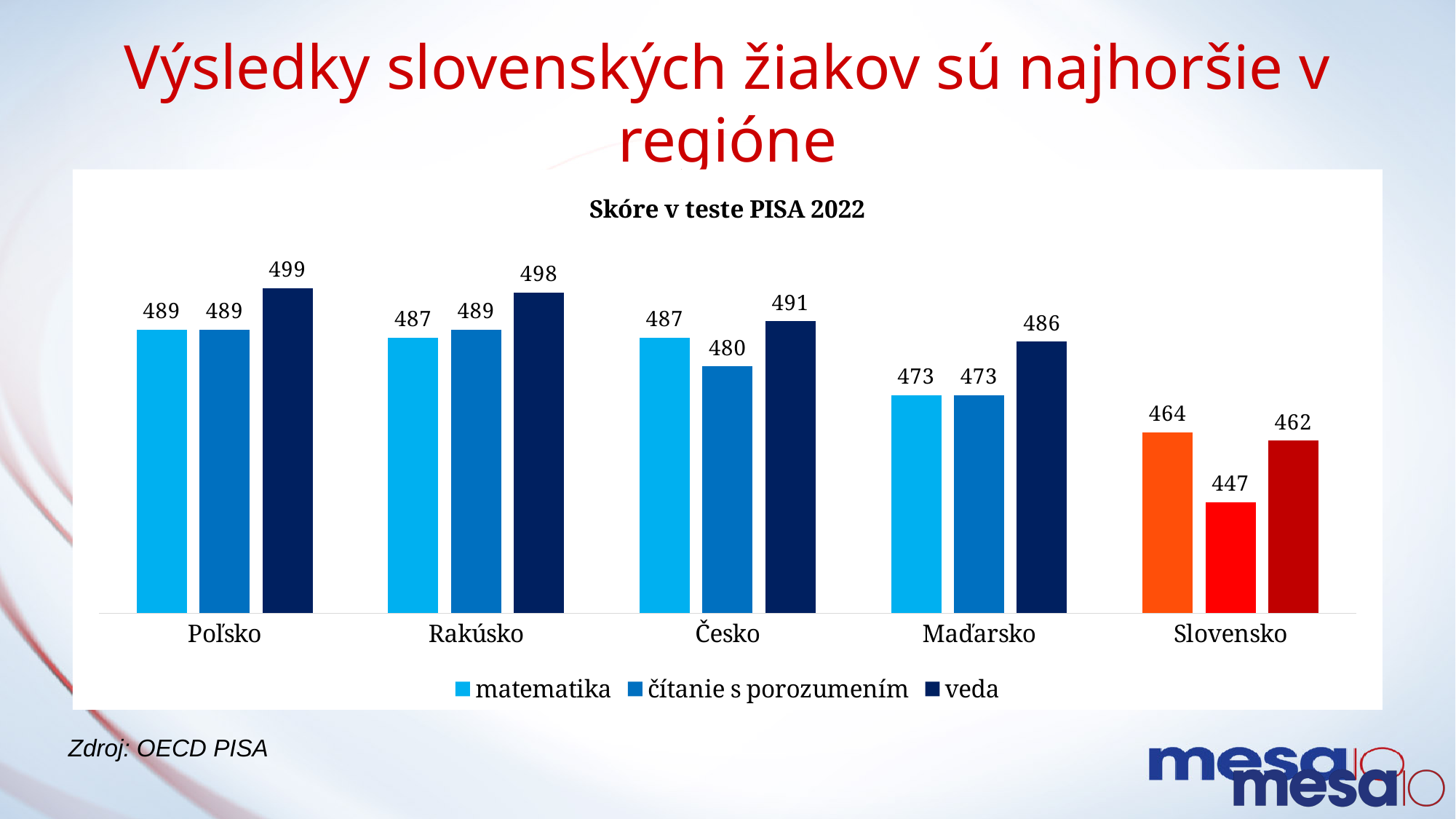
Which country has the highest veda score? Poľsko What is the čítanie s porozumením score for Česko? 480 How many series does the legend list? 3 Which country has the lowest čítanie s porozumením score? Slovensko What is the difference between the matematika and čítanie s porozumením scores for Slovensko? 17 What is the title of the chart? Skóre v teste PISA 2022 What kind of chart is shown? bar chart What is the difference between the veda scores of Poľsko and Slovensko? 37 How many countries are shown on the x axis? 5 What is the matematika score for Slovensko? 464 What is the veda score for Poľsko? 499 Which is larger: the matematika score for Maďarsko or the matematika score for Slovensko? Maďarsko